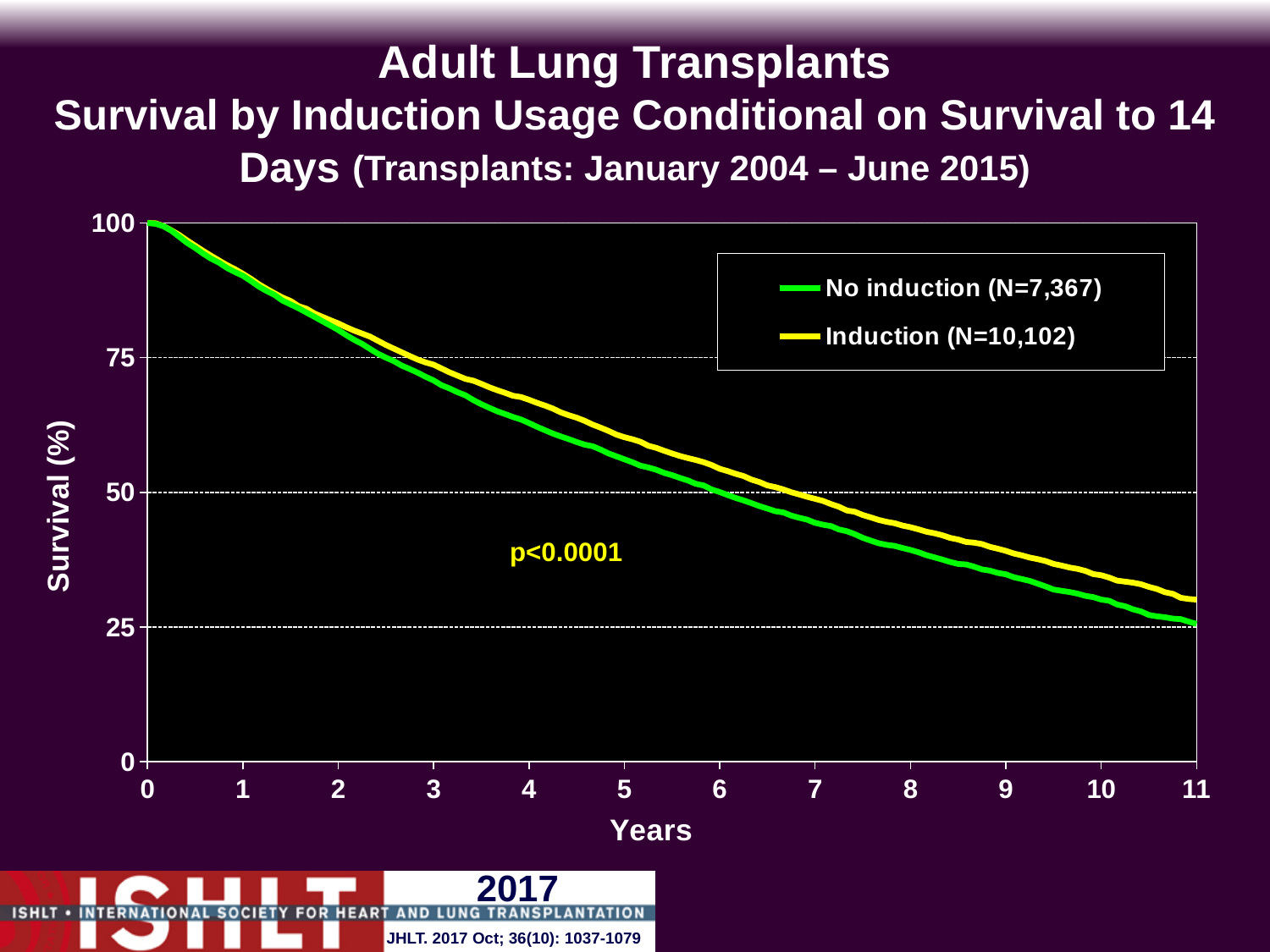
Is the survival for the Induction group at 5 years greater or less than 50? greater How many series does the legend list? 2 Do the survival curves rise or fall as years increase? Fall At 5 years, which group has higher survival: Induction or No induction? Induction At 8 years, which group has higher survival: Induction or No induction? Induction Is the survival for the No induction group at 4 years greater or less than 75? less Is the survival for the No induction group at 8 years greater or less than 50? less What is the sample size (N) for the No induction group shown in the legend? 7,367 What is the sample size (N) for the Induction group shown in the legend? 10,102 What kind of chart is shown on the slide? Line chart